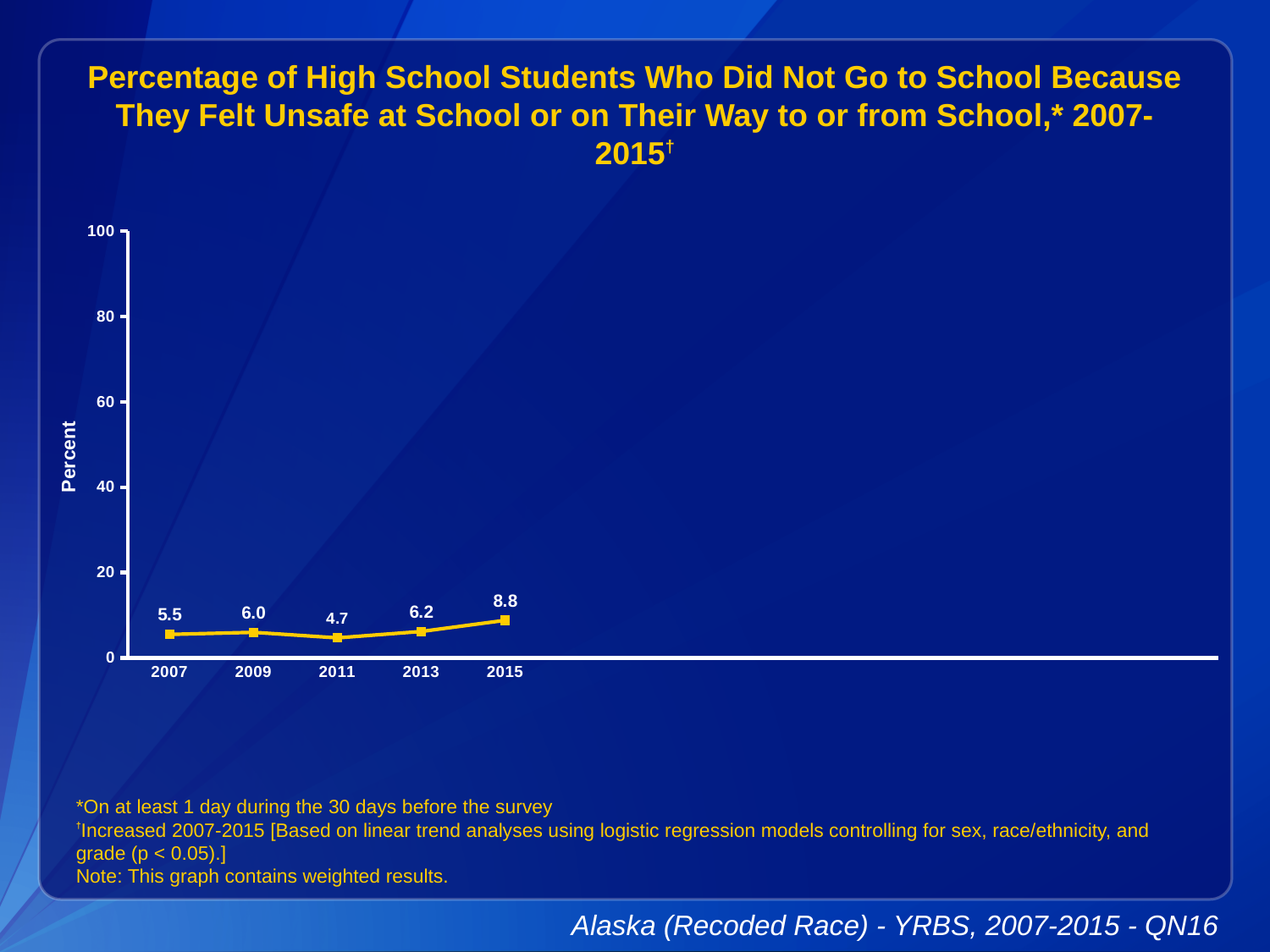
How many years are plotted on the chart? 5 Is the value for 2015 greater or less than 20? less What is the value for 2015? 8.8 Which year has the lowest value? 2011 What is the value for 2011? 4.7 What is the label on the y axis? Percent Which is larger, the value for 2009 or the value for 2013? 2013 Do the values rise or fall from 2011 to 2015? rise What kind of chart is shown on the slide? line chart Which year has the highest value? 2015 What is the value for 2007? 5.5 What is the difference between the values for 2015 and 2007? 3.3